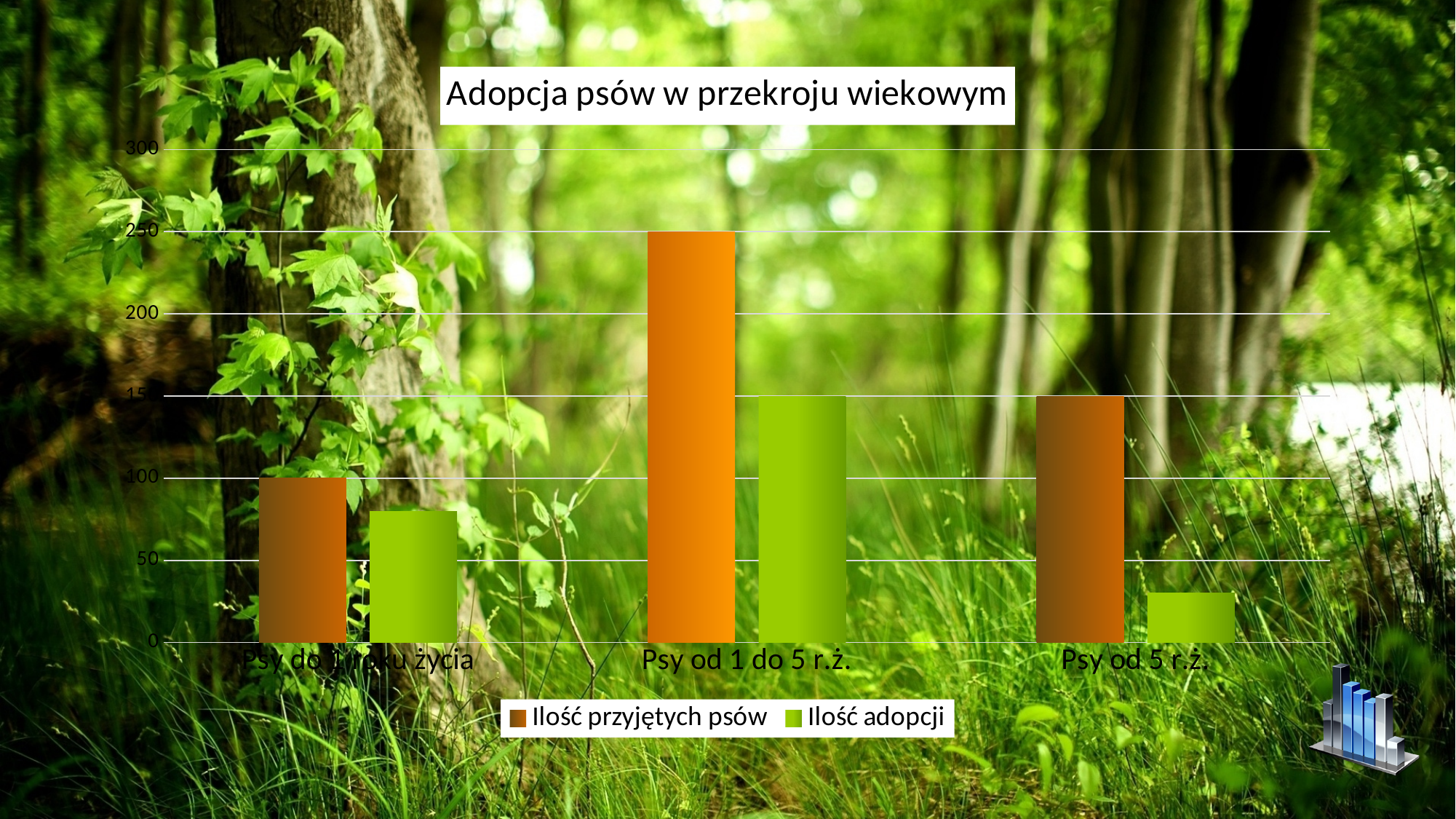
How many categories are shown on the x axis? 3 Which category has the highest value for Ilość przyjętych psów? Psy od 1 do 5 r.ż. What is the difference between Ilość przyjętych psów and Ilość adopcji for Psy od 1 do 5 r.ż.? 100 What type of chart is shown on the slide? bar chart What is the value of Ilość adopcji for Psy od 1 do 5 r.ż.? 150 What is the value of Ilość przyjętych psów for Psy do 1 roku życia? 100 How many series does the legend list? 2 What is the title of the chart? Adopcja psów w przekroju wiekowym What is the value of Ilość przyjętych psów for Psy od 5 r.ż.? 150 Which category has the lowest value for Ilość adopcji? Psy od 5 r.ż. Is the value of Ilość adopcji for Psy od 5 r.ż. greater or less than 50? less What is the value of Ilość przyjętych psów for Psy od 1 do 5 r.ż.? 250